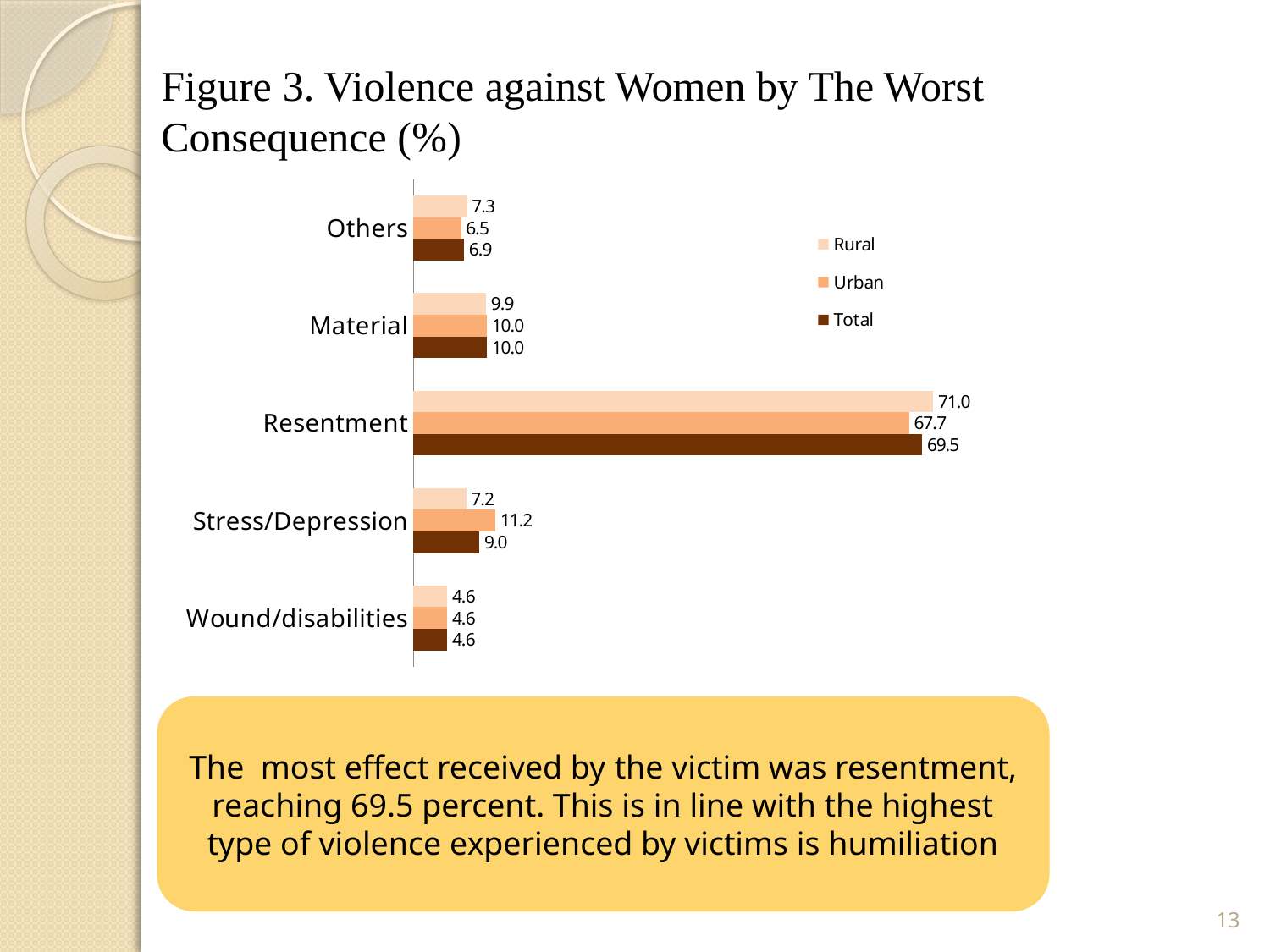
Which category has the lowest Rural value? Wound/disabilities What is the difference between the Urban and Rural values for Material? 0.1 What is the Rural value for Others? 7.3 Which is larger for Stress/Depression, the Rural value or the Urban value? Urban How many categories are shown on the chart? 5 What kind of chart is shown on the slide? Bar chart What is the difference between the Rural and Urban values for Resentment? 3.3 What is the title of the chart? Figure 3. Violence against Women by The Worst Consequence (%) Which category has the highest Total value? Resentment What is the Total value for Resentment? 69.5 How many series does the legend list? 3 What is the Urban value for Stress/Depression? 11.2